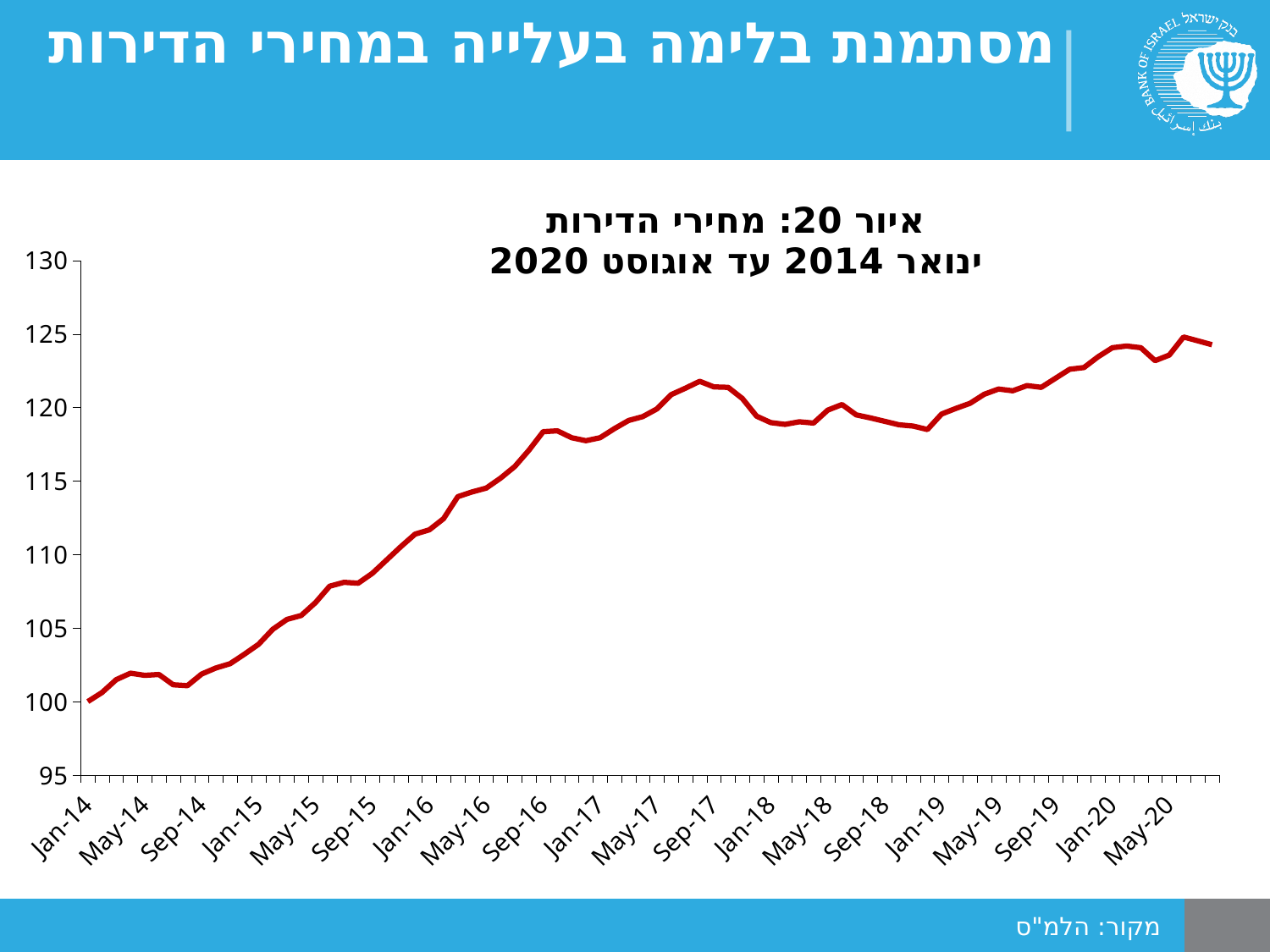
Is the value for Sep-17 greater or less than 120? greater What is the title of the chart? איור 20: מחירי הדירות ינואר 2014 עד אוגוסט 2020 What colour is the plotted line? red Is the value for May-15 greater or less than 105? greater Is the value for Jan-14 greater or less than 105? less Overall, do the values rise or fall from Jan-14 to the end of the series? rise What kind of chart is shown on the slide? line chart Which is larger, the value for Jan-14 or the value for May-20? May-20